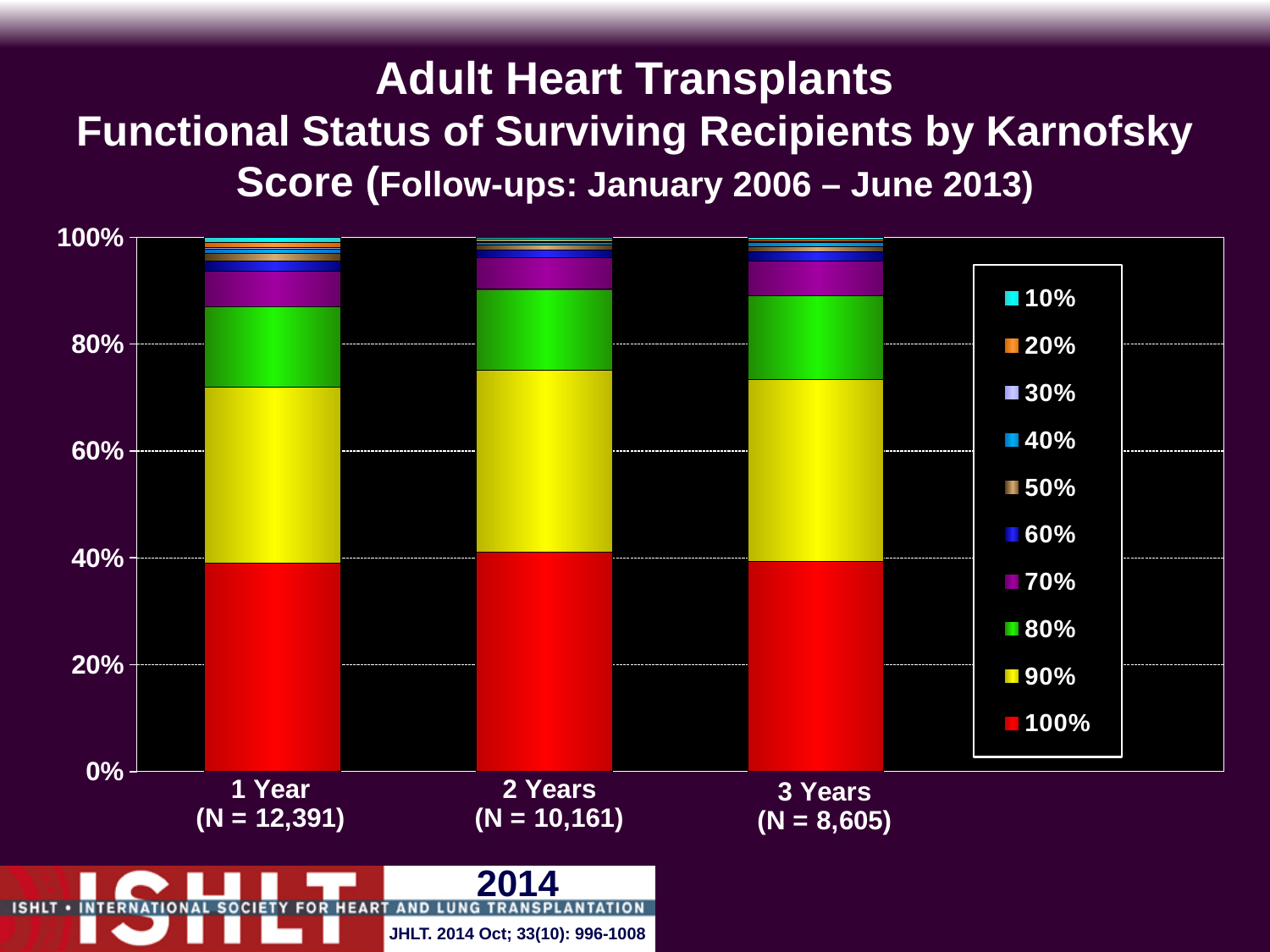
Is the top of the 80% Karnofsky segment for 3 Years greater or less than 80%? greater What kind of chart is shown on the slide? Stacked bar chart Which colour represents the 100% Karnofsky score in the legend? Red Is the top of the 90% Karnofsky segment for 1 Year greater or less than 80%? less How many categories (follow-up time points) are shown on the x axis? 3 What is the total height of each stacked bar? 100% How many series does the legend list? 10 What is the N shown for the 1 Year category? N = 12,391 Which Karnofsky score category occupies the largest share of each bar? 100% Is the top of the 90% Karnofsky segment for 2 Years greater or less than 60%? greater